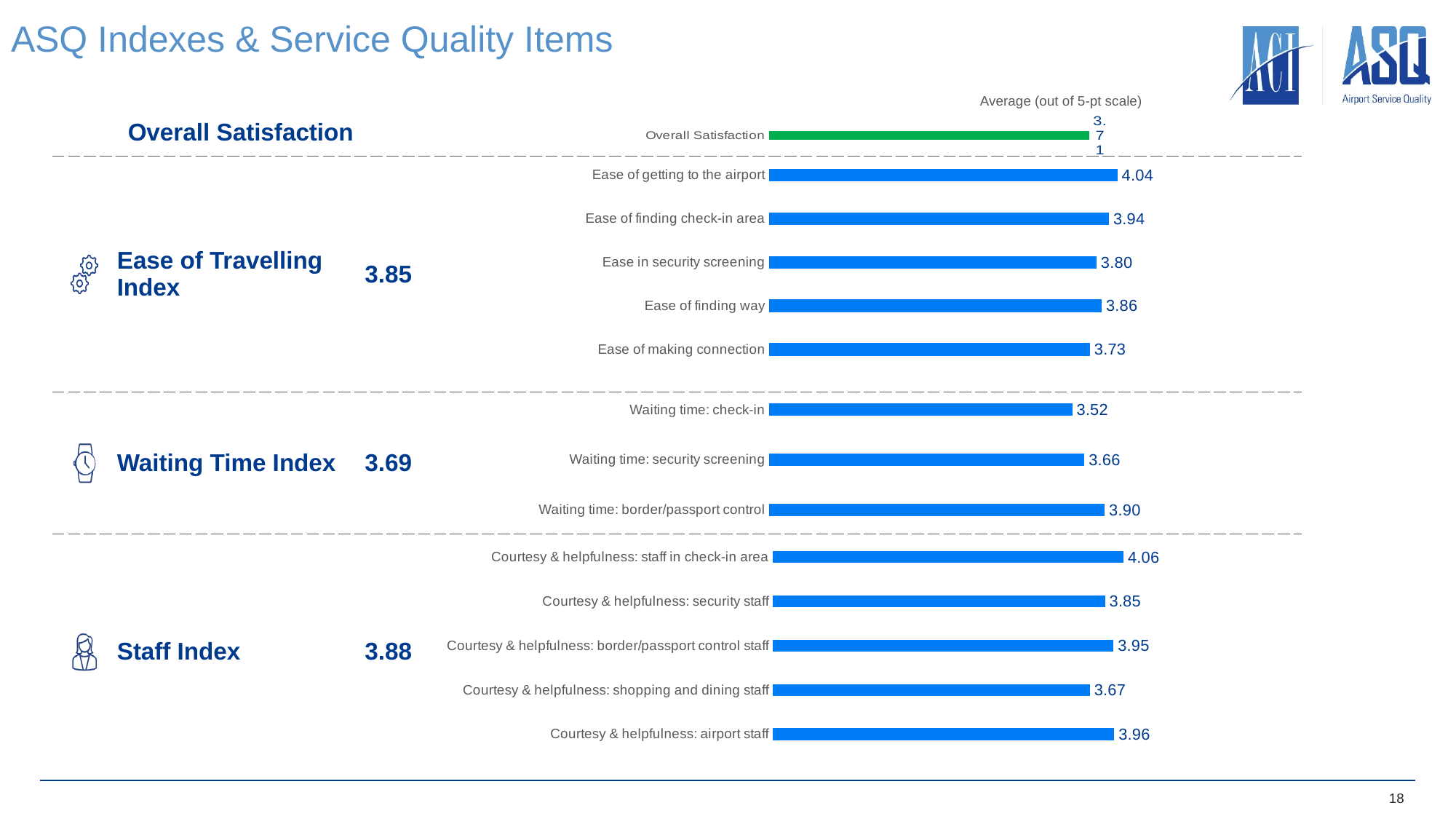
In the Ease of Travelling section chart, how many items are plotted? 5 What colour is the Overall Satisfaction bar at the top of the slide? Green What kind of chart is used to show the service quality items on this slide? Bar chart In the Waiting Time section chart, what is the value for Waiting time: check-in? 3.52 In the Waiting Time section chart, which item has the highest value? Waiting time: border/passport control In the Ease of Travelling section chart, which item has the lowest value? Ease of making connection In the Ease of Travelling section chart, what is the value for Ease of getting to the airport? 4.04 In the Waiting Time section chart, how many items are plotted? 3 In the Ease of Travelling section chart, what is the difference between Ease of getting to the airport and Ease of making connection? 0.31 In the Staff section chart, which is larger: Courtesy & helpfulness: security staff or Courtesy & helpfulness: airport staff? Courtesy & helpfulness: airport staff In the Staff section chart, which item has the highest value? Courtesy & helpfulness: staff in check-in area In the Staff section chart, what is the value for Courtesy & helpfulness: shopping and dining staff? 3.67